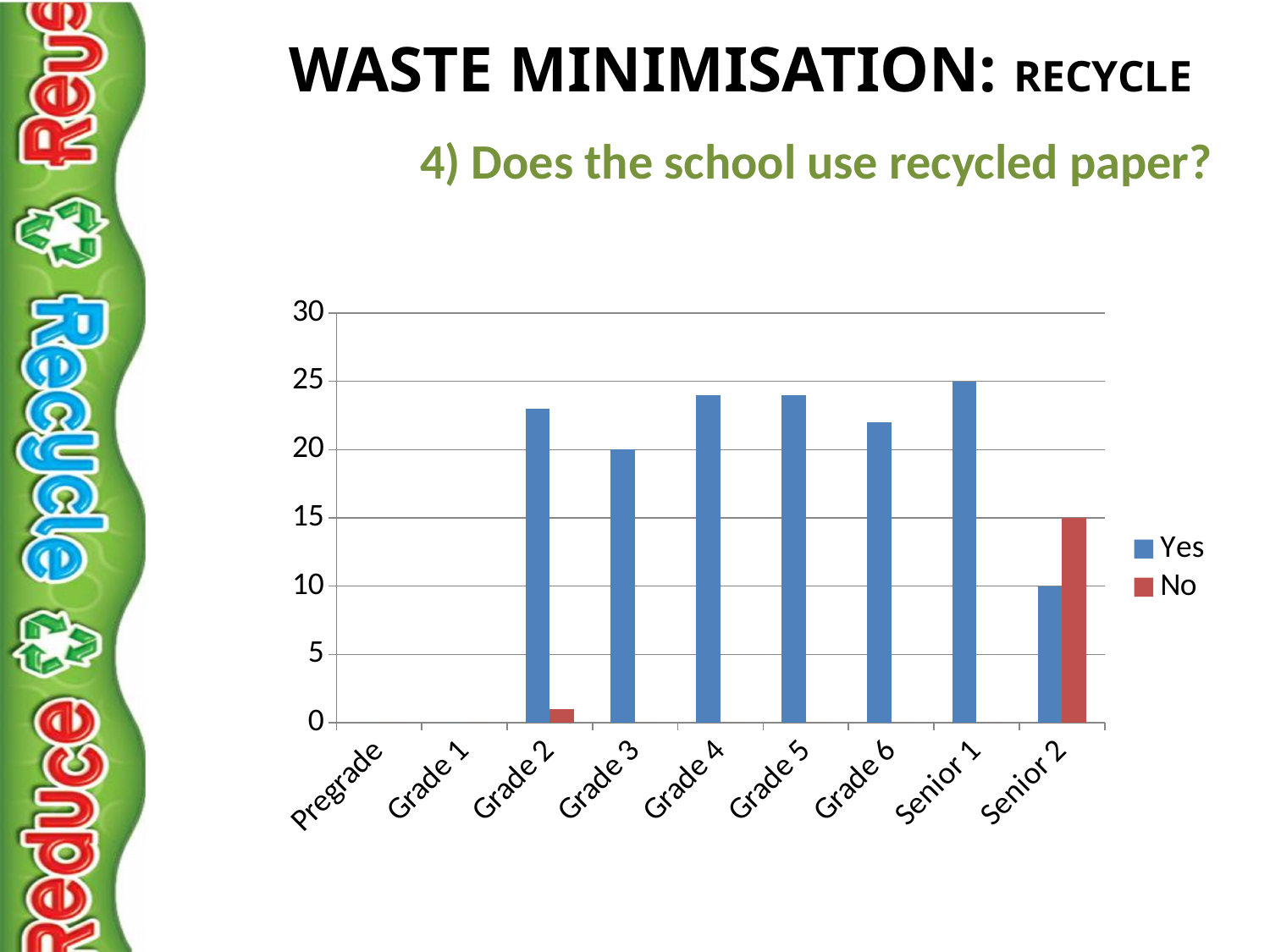
Which category has the highest No bar? Senior 2 How many series does the chart legend list? 2 Which category has the highest Yes bar? Senior 1 How many categories are shown on the x axis of the chart? 9 What is the Yes value for Senior 1? 25 For Senior 2, which is larger, the Yes value or the No value? No Which colour represents the No series in the legend? Red What is the difference between the No value and the Yes value for Senior 2? 5 What is the No value for Senior 2? 15 Is the Yes value for Grade 2 greater or less than 20? greater What is the Yes value for Grade 3? 20 What kind of chart is shown on the slide? Bar chart